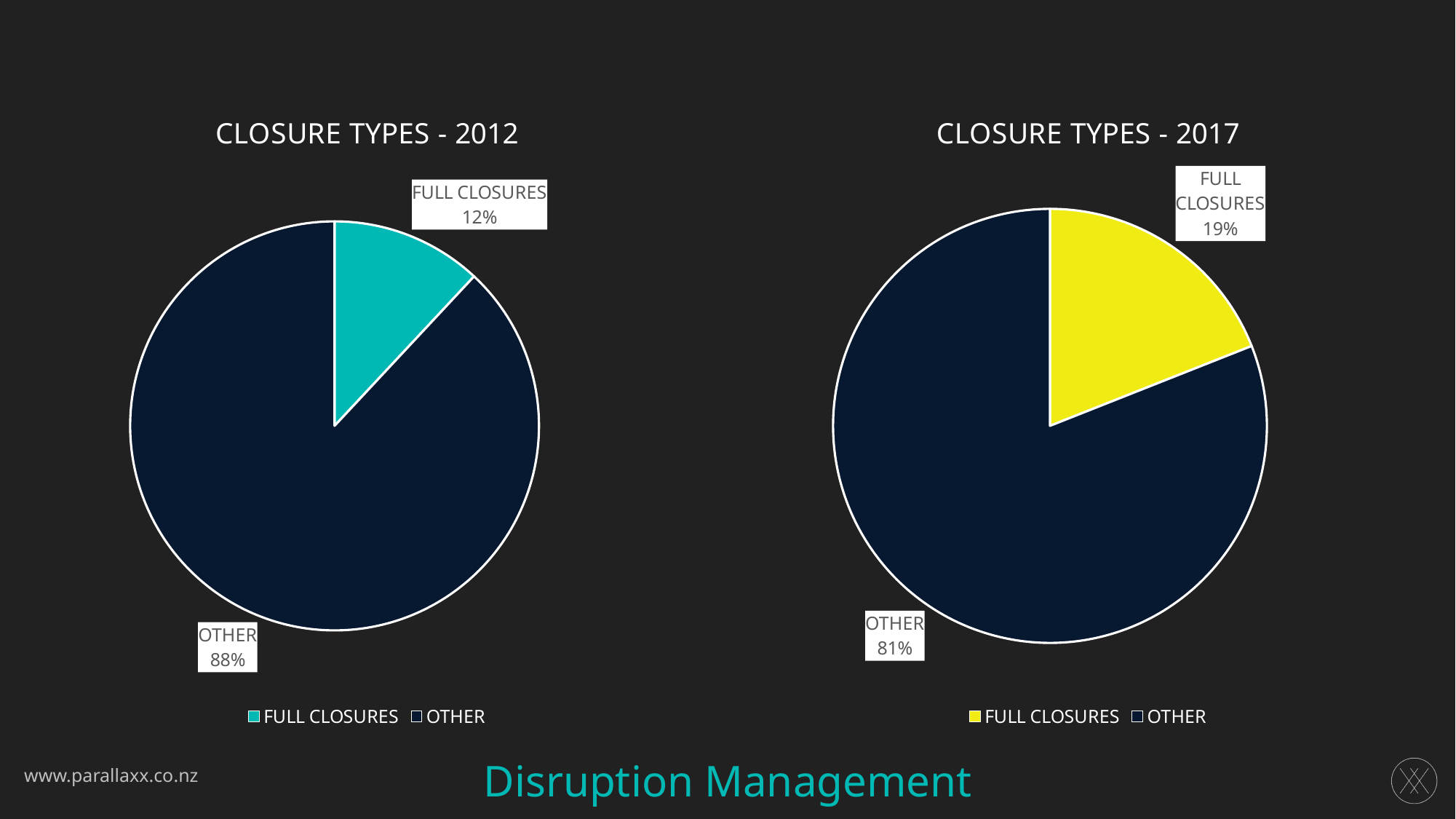
Which chart shows a larger FULL CLOSURES share, CLOSURE TYPES - 2012 or CLOSURE TYPES - 2017? CLOSURE TYPES - 2017 What colour is the FULL CLOSURES slice in the CLOSURE TYPES - 2017 chart? Yellow How many slices does the CLOSURE TYPES - 2012 chart have? 2 In the CLOSURE TYPES - 2017 chart, what is the difference between the OTHER and FULL CLOSURES shares? 62% What kind of chart is the CLOSURE TYPES - 2017 chart? Pie chart In the CLOSURE TYPES - 2012 chart, what is the difference between the OTHER and FULL CLOSURES shares? 76% In the CLOSURE TYPES - 2017 chart, what share of the pie is OTHER? 81% In the CLOSURE TYPES - 2017 chart, what share of the pie is FULL CLOSURES? 19% In the CLOSURE TYPES - 2012 chart, what share of the pie is FULL CLOSURES? 12% In the CLOSURE TYPES - 2012 chart, which slice is the largest? OTHER In the CLOSURE TYPES - 2017 chart, which slice is the smallest? FULL CLOSURES